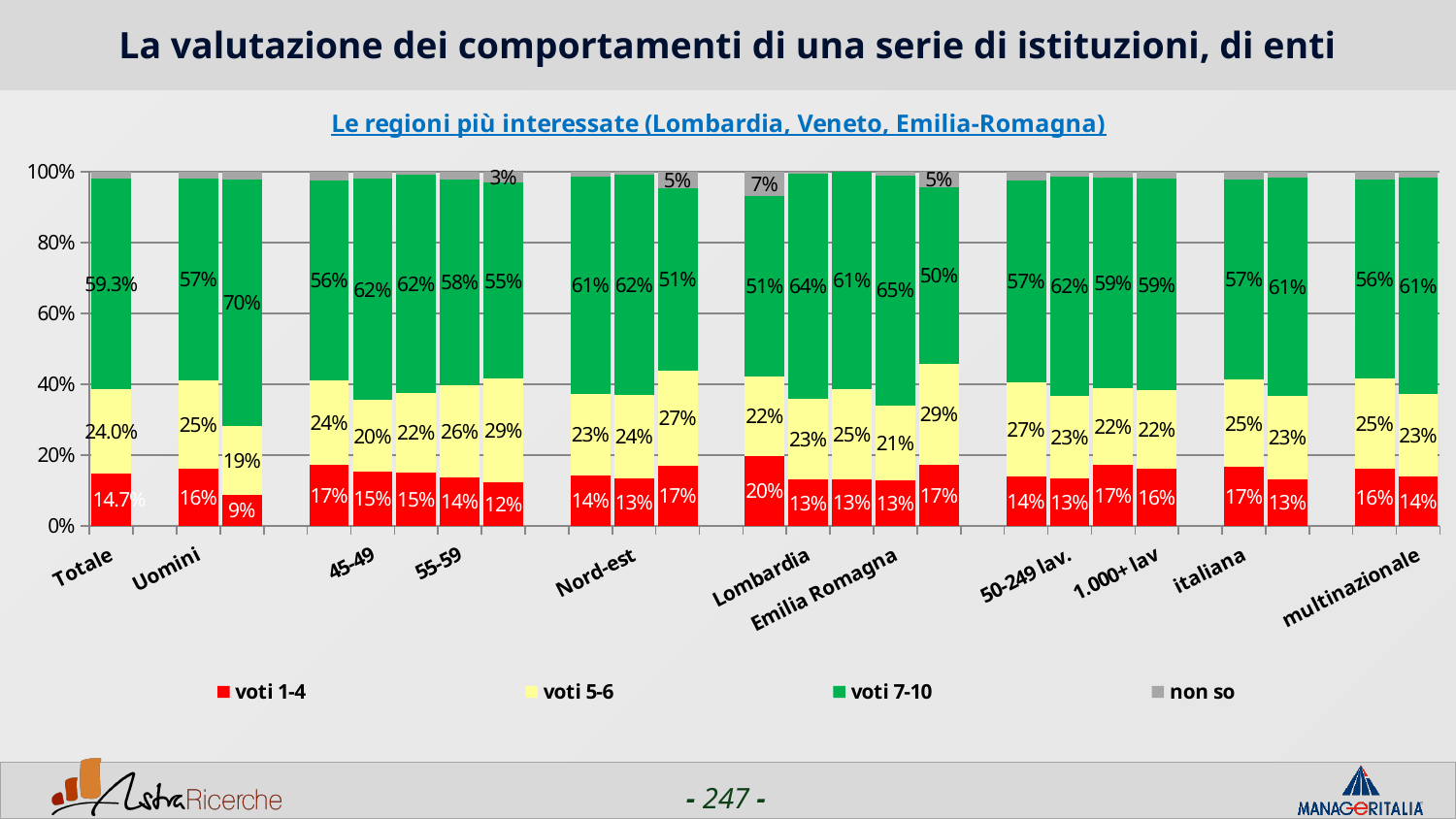
What is the 'voti 7-10' value for Totale? 59.3% What is the lowest 'voti 1-4' value shown on any bar? 9% What is the 'voti 1-4' value for Uomini? 16% Which series is shown in red in the legend? voti 1-4 What is the 'voti 1-4' value for Totale? 14.7% What is the highest 'voti 7-10' value shown on any bar? 70% Which is larger, the 'voti 5-6' value for Totale or for Uomini? Uomini What is the 'voti 5-6' value for Totale? 24.0% What type of chart is shown on the slide? stacked bar chart How many series does the legend list? 4 What is the highest 'voti 1-4' value shown on any bar? 20% What is the 'voti 7-10' value for Uomini? 57%